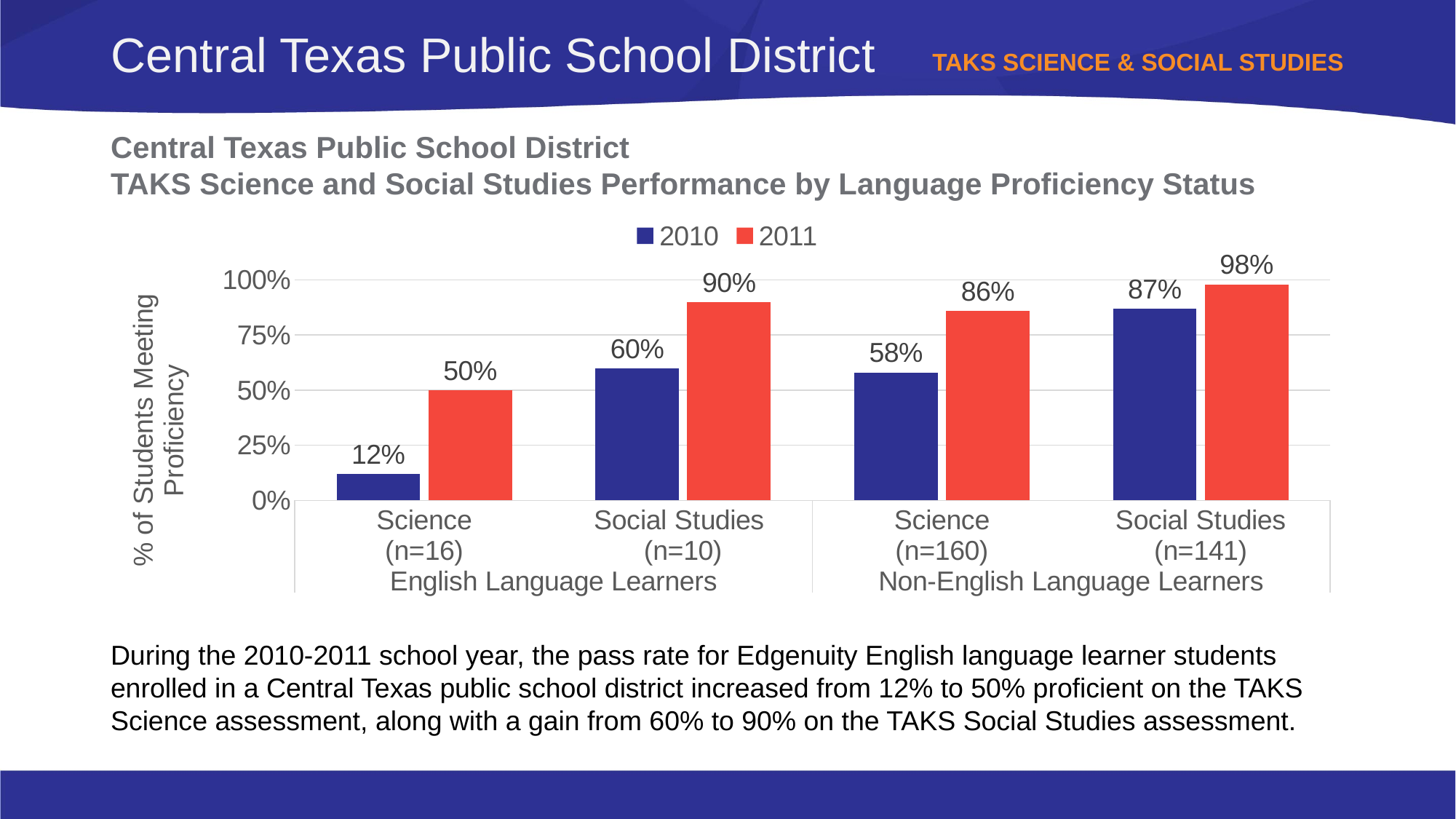
Which category has the lowest 2010 value? Science (n=16), English Language Learners What is the difference between the 2011 and 2010 values for Social Studies (n=10) among English Language Learners? 30% What is the difference between the 2011 and 2010 values for Science (n=16) among English Language Learners? 38% How many series does the legend list? 2 What was the 2010 value for Science (n=16) among English Language Learners? 12% Which category has the highest 2011 value? Social Studies (n=141), Non-English Language Learners How many categories are shown on the x axis? 4 What is the label of the y axis? % of Students Meeting Proficiency What kind of chart is shown on the slide? Bar chart What was the 2011 value for Science (n=160) among Non-English Language Learners? 86% Which is larger: the 2010 value for Social Studies (n=10) among English Language Learners or the 2010 value for Science (n=160) among Non-English Language Learners? Social Studies (n=10), English Language Learners What was the 2011 value for Social Studies (n=141) among Non-English Language Learners? 98%